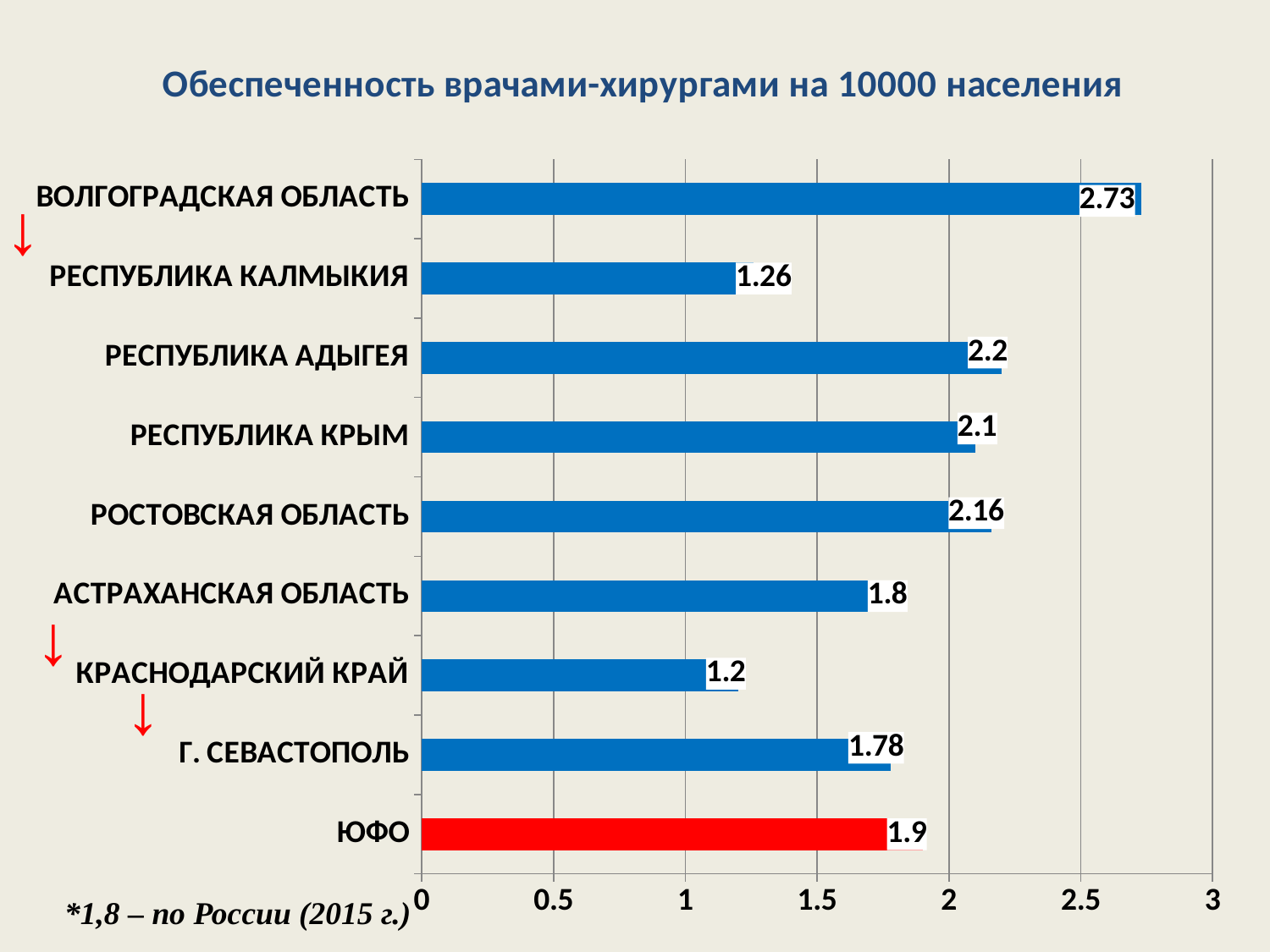
What is the difference between the values for Волгоградская область and Республика Калмыкия? 1.47 What is the value for Волгоградская область? 2.73 Which region has the highest value? Волгоградская область Is the value for Республика Крым greater or less than 2? greater Which category has the lowest value? Краснодарский край How many categories are shown in the chart? 9 What is the value for Краснодарский край? 1.2 Which is larger, the value for Республика Адыгея or the value for Ростовская область? Республика Адыгея What is the value for ЮФО? 1.9 What is the value for Республика Калмыкия? 1.26 What kind of chart is shown on the slide? Bar chart Which bar is coloured red instead of blue? ЮФО